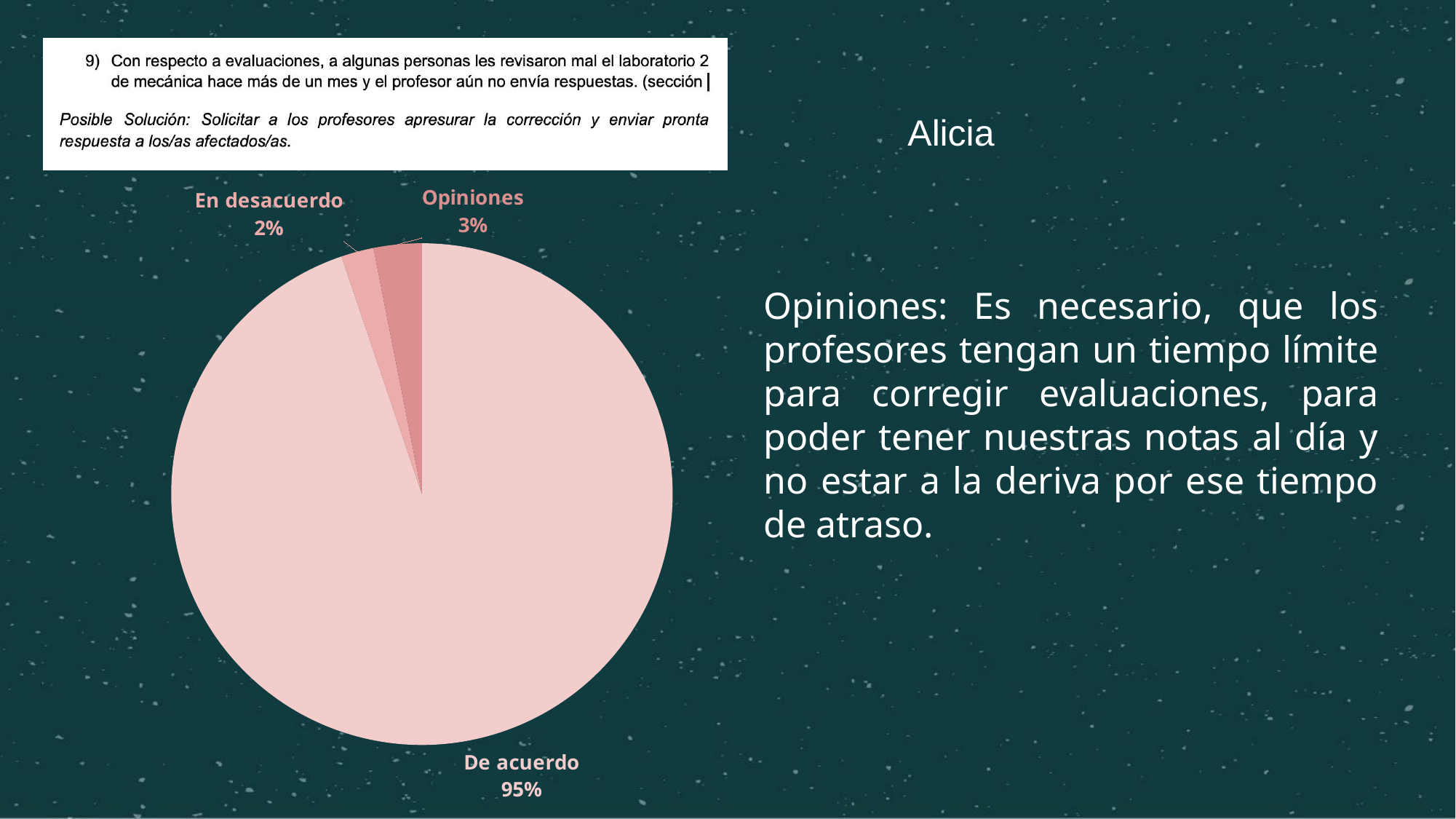
What is the difference in percentage points between the "Opiniones" slice and the "En desacuerdo" slice? 1 Which slice is larger, "Opiniones" or "En desacuerdo"? Opiniones Which slice of the pie is the smallest? En desacuerdo What kind of chart is shown on the slide? pie chart What share of the pie do the "En desacuerdo" and "Opiniones" slices make up together? 5% What is the difference in percentage points between the "De acuerdo" slice and the "Opiniones" slice? 92 What percentage of the pie is labelled "De acuerdo"? 95% What percentage of the pie is labelled "En desacuerdo"? 2% Which slice of the pie is drawn in the darkest shade of pink? Opiniones What percentage of the pie is labelled "Opiniones"? 3% How many slices does the pie chart have? 3 Which slice of the pie is the largest? De acuerdo